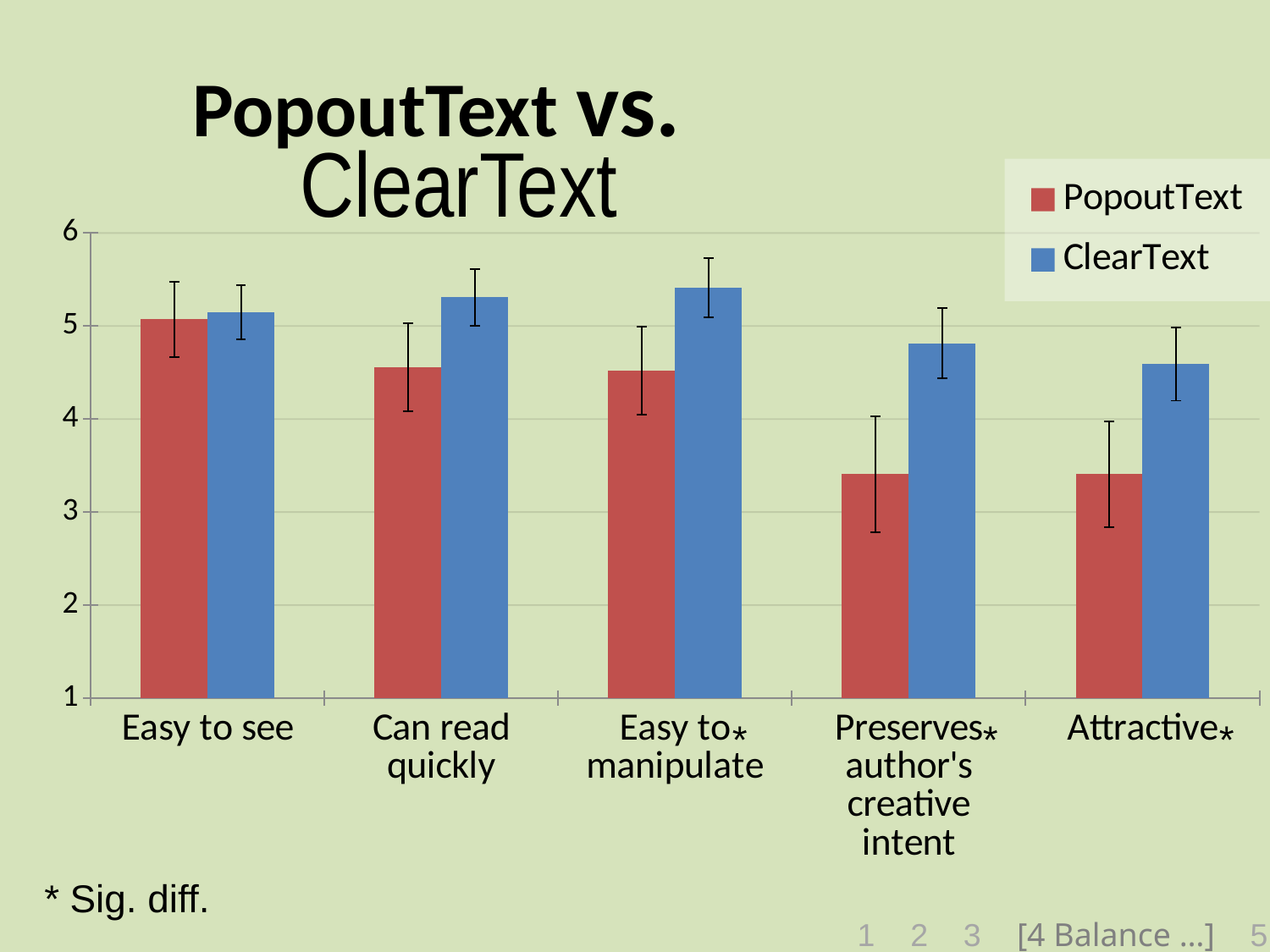
Is the PopoutText value for 'Can read quickly' greater or less than 4? greater How many series does the legend list? 2 Is the ClearText value for 'Attractive' greater or less than 4? greater Is the ClearText value for 'Easy to manipulate' greater or less than 5? greater Which category has the highest PopoutText value? Easy to see For 'Attractive', which series has the larger value, PopoutText or ClearText? ClearText How many categories are shown on the x axis? 5 Which colour represents PopoutText in the legend? red What kind of chart is shown on the slide? bar chart For 'Can read quickly', which series has the larger value, PopoutText or ClearText? ClearText